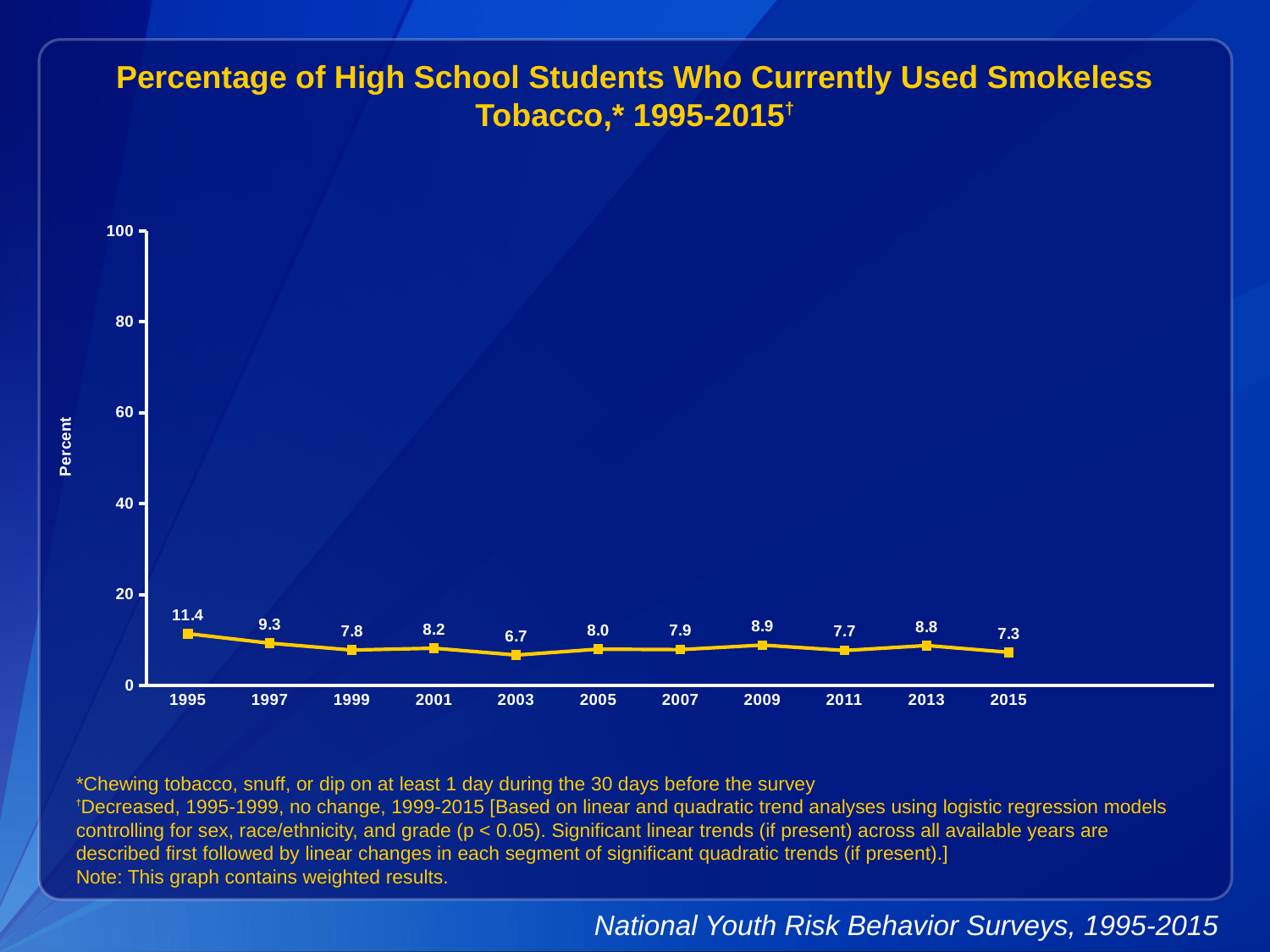
Which year has the lowest value on the chart? 2003 Which year has the highest value on the chart? 1995 What was the percentage of high school students who currently used smokeless tobacco in 1995? 11.4 What value is shown for 2015? 7.3 What kind of chart is shown on the slide? Line chart Did the value rise or fall from 1995 to 1999? Fall Is the value for 1995 greater or less than 20? less What is the difference between the values for 1995 and 2015? 4.1 Which year has the larger value, 2009 or 2011? 2009 What value is shown for 2003? 6.7 How many years are plotted on the chart? 11 What is the label on the y axis? Percent